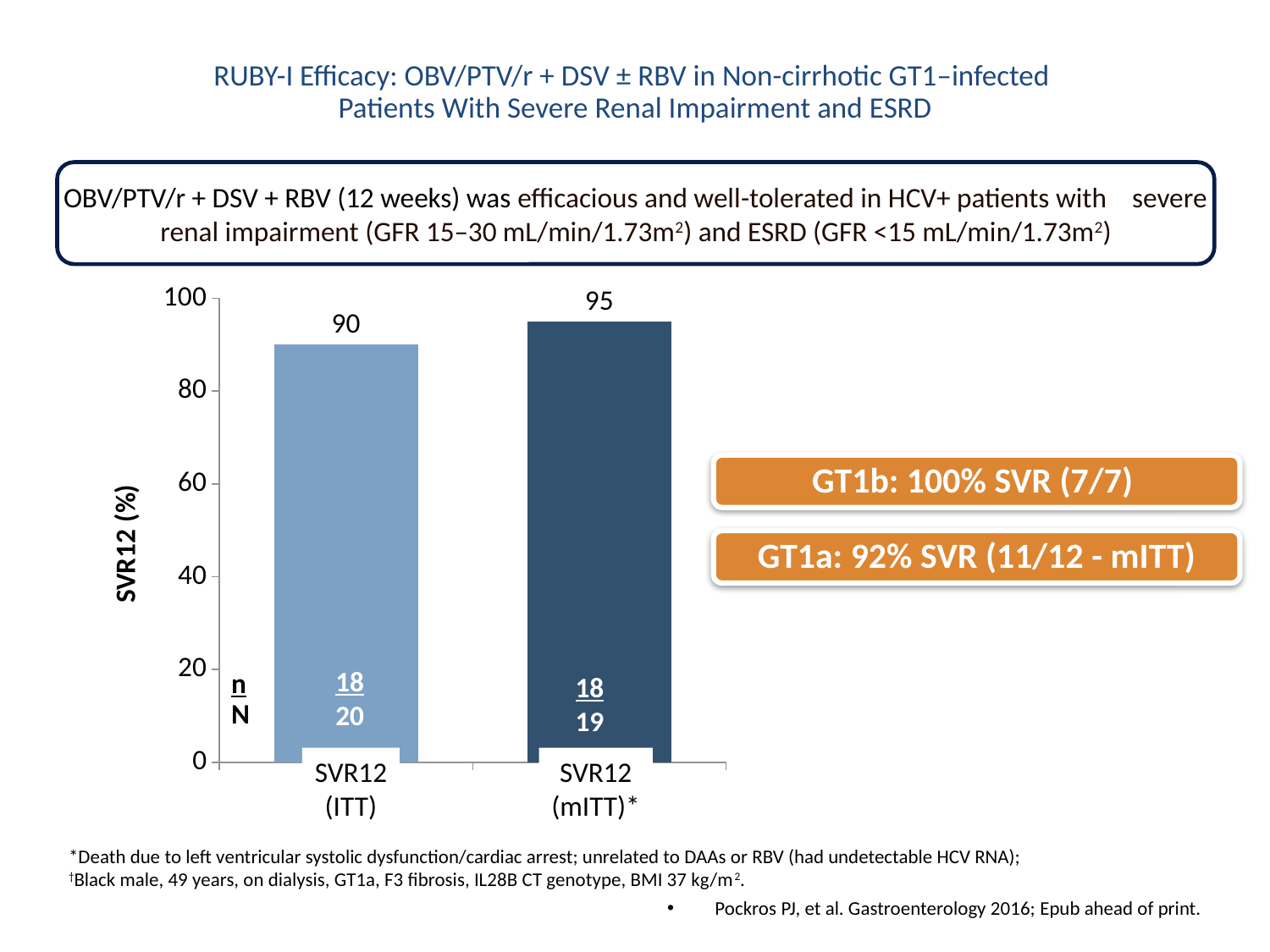
Which category has the lower SVR12 value? SVR12 (ITT) How many bars are plotted in the chart? 2 What kind of chart is shown on the slide? Bar chart What is the SVR12 value for SVR12 (ITT)? 90 What is the difference between the SVR12 (mITT)* and SVR12 (ITT) values? 5 What is the label of the y axis? SVR12 (%) Which category has the higher SVR12 value? SVR12 (mITT)* What is the SVR12 value for SVR12 (mITT)*? 95 What is the n/N shown for the SVR12 (mITT)* bar? 18/19 Is the value for SVR12 (ITT) greater or less than 80? greater What is the maximum value shown on the y axis? 100 What is the n/N shown for the SVR12 (ITT) bar? 18/20